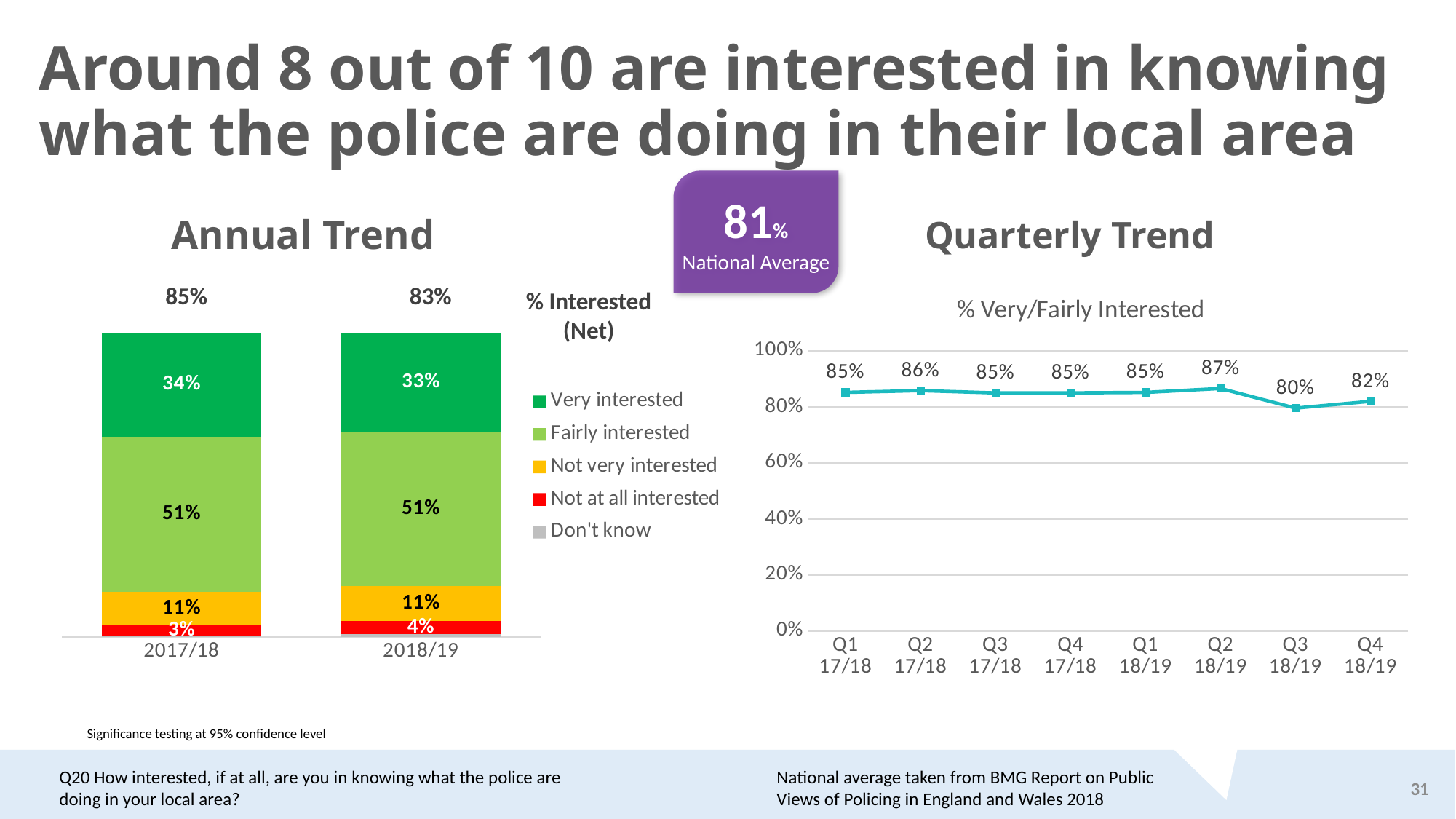
In the Annual Trend chart, what is the difference between the Very interested values for 2017/18 and 2018/19? 1% In the Quarterly Trend chart, what is the value for Q2 18/19? 87% In the Annual Trend chart, what is the % Interested (Net) value shown above the 2018/19 bar? 83% What is the National Average value shown on the slide? 81% In the Quarterly Trend chart, which quarter has the highest value? Q2 18/19 What kind of chart is the Annual Trend chart? Stacked bar chart In the Quarterly Trend chart, which quarter has the lowest value? Q3 18/19 In the Quarterly Trend chart, how many quarters are plotted? 8 In the Quarterly Trend chart, what is the difference between the values for Q2 18/19 and Q3 18/19? 7% In the Annual Trend chart, how many series does the legend list? 5 In the Annual Trend chart, what percentage were Not at all interested in 2018/19? 4% In the Annual Trend chart, what percentage were Very interested in 2017/18? 34%